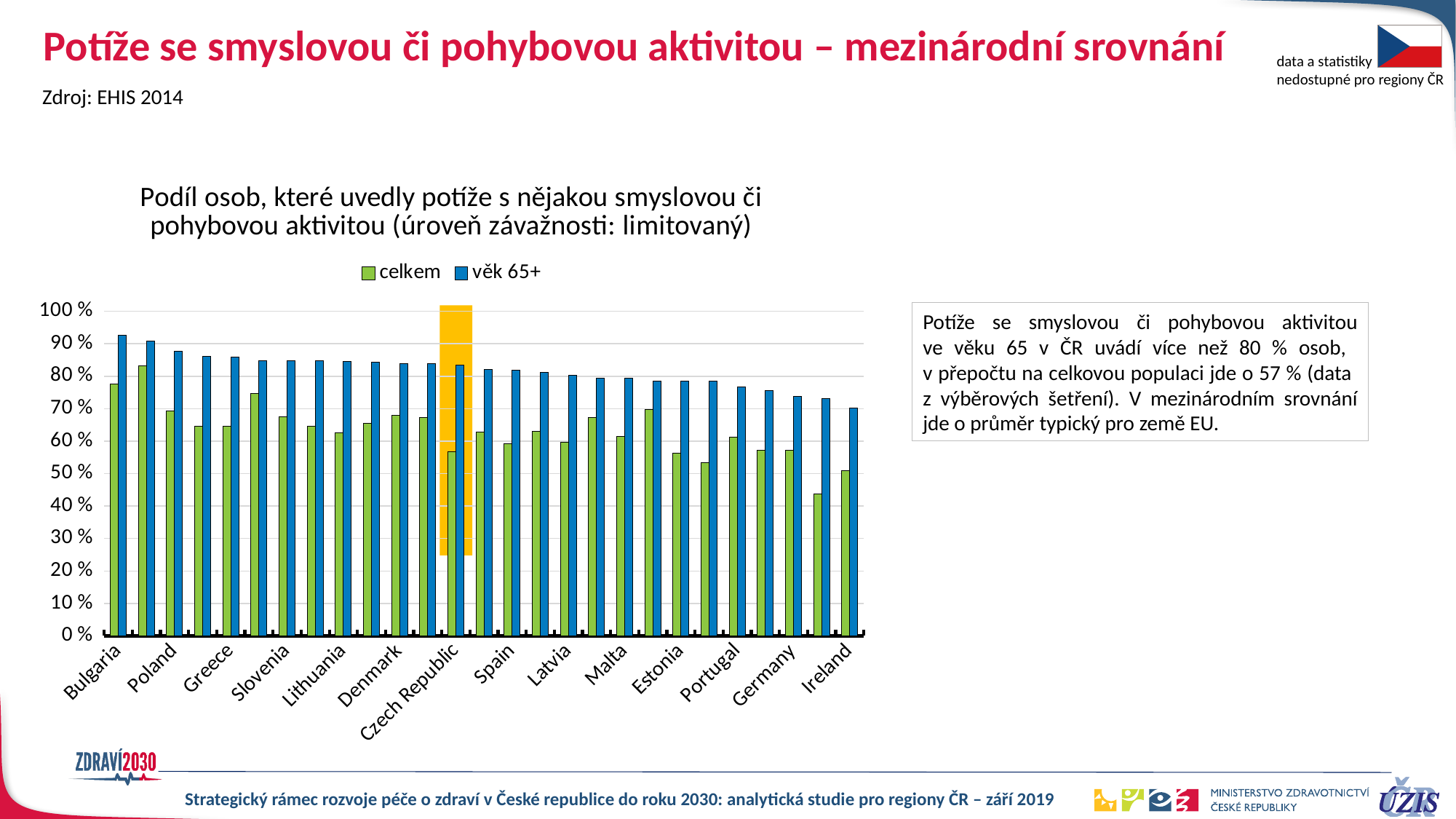
Is the věk 65+ value for Bulgaria greater or less than 90 %? greater How many series does the chart legend list? 2 Do the věk 65+ values generally rise or fall from left to right along the x axis? fall What kind of chart is shown on the slide? bar chart Which is larger, the celkem value for Denmark or the celkem value for Czech Republic? Denmark What are the two series named in the chart legend? celkem and věk 65+ Is the věk 65+ value for Czech Republic greater or less than 80 %? greater Which country is highlighted with an orange background in the chart? Czech Republic Which labelled country has the lowest value for the věk 65+ series? Ireland Which country has the highest value for the věk 65+ series? Bulgaria Is the celkem value for Czech Republic greater or less than 60 %? less